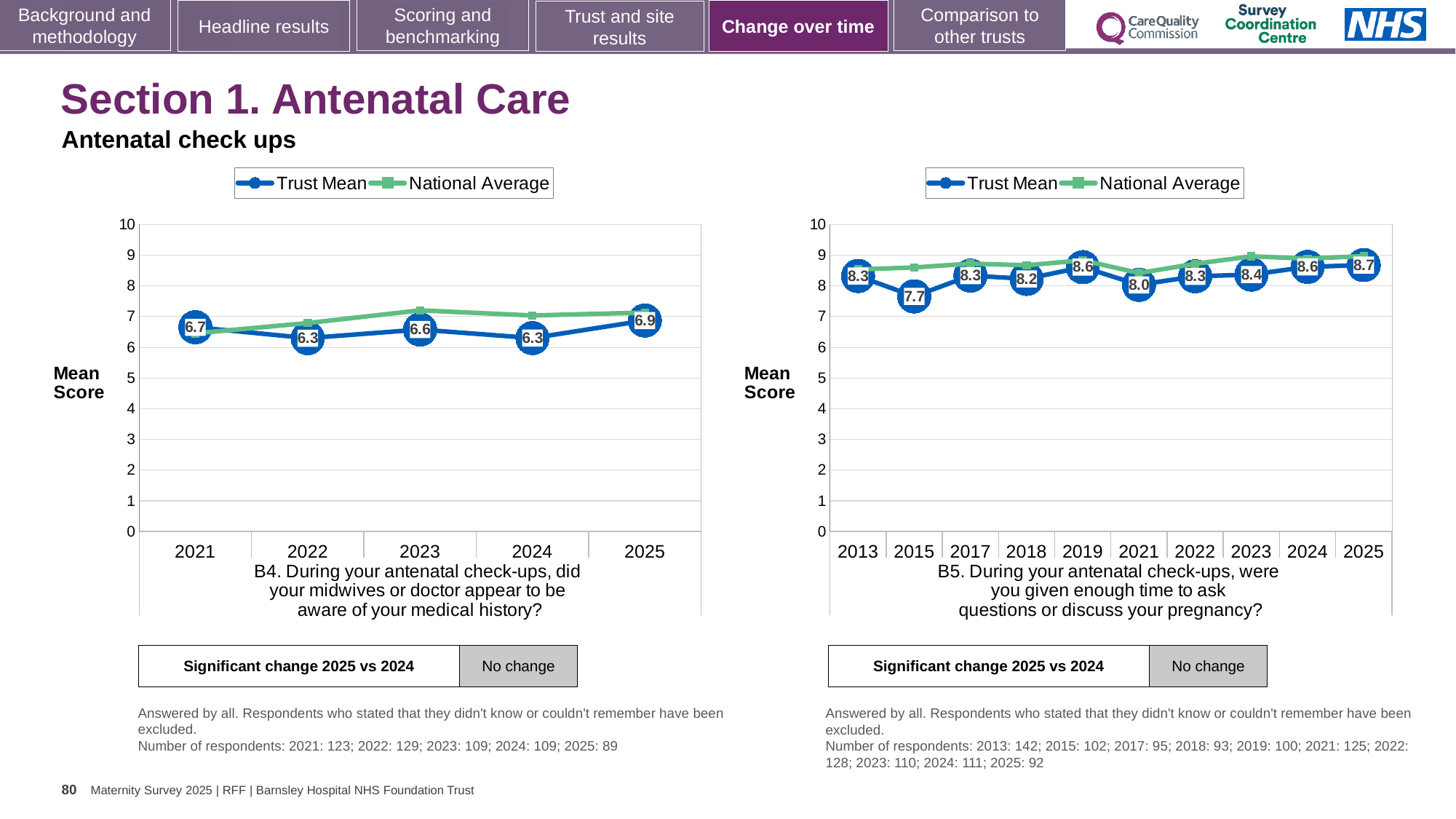
In the right chart (B5), what is the Trust Mean score for 2019? 8.6 In the right chart (B5), what is the Trust Mean score for 2015? 7.7 In the right chart (B5), is the National Average value for 2013 greater or less than 8? greater How many series does the legend of the right chart (B5) list? 2 In the left chart (B4), what is the Trust Mean score for 2025? 6.9 In the left chart (B4), how many years are plotted on the x axis? 5 In the right chart (B5), which year has the lowest Trust Mean score? 2015 In the left chart (B4), which year has the highest Trust Mean score? 2025 In the left chart (B4), what is the Trust Mean score for 2022? 6.3 In the right chart (B5), is the Trust Mean score for 2021 larger or smaller than the score for 2022? smaller In the right chart (B5), which year has the highest Trust Mean score? 2025 In the left chart (B4), what is the difference between the Trust Mean scores for 2025 and 2024? 0.6